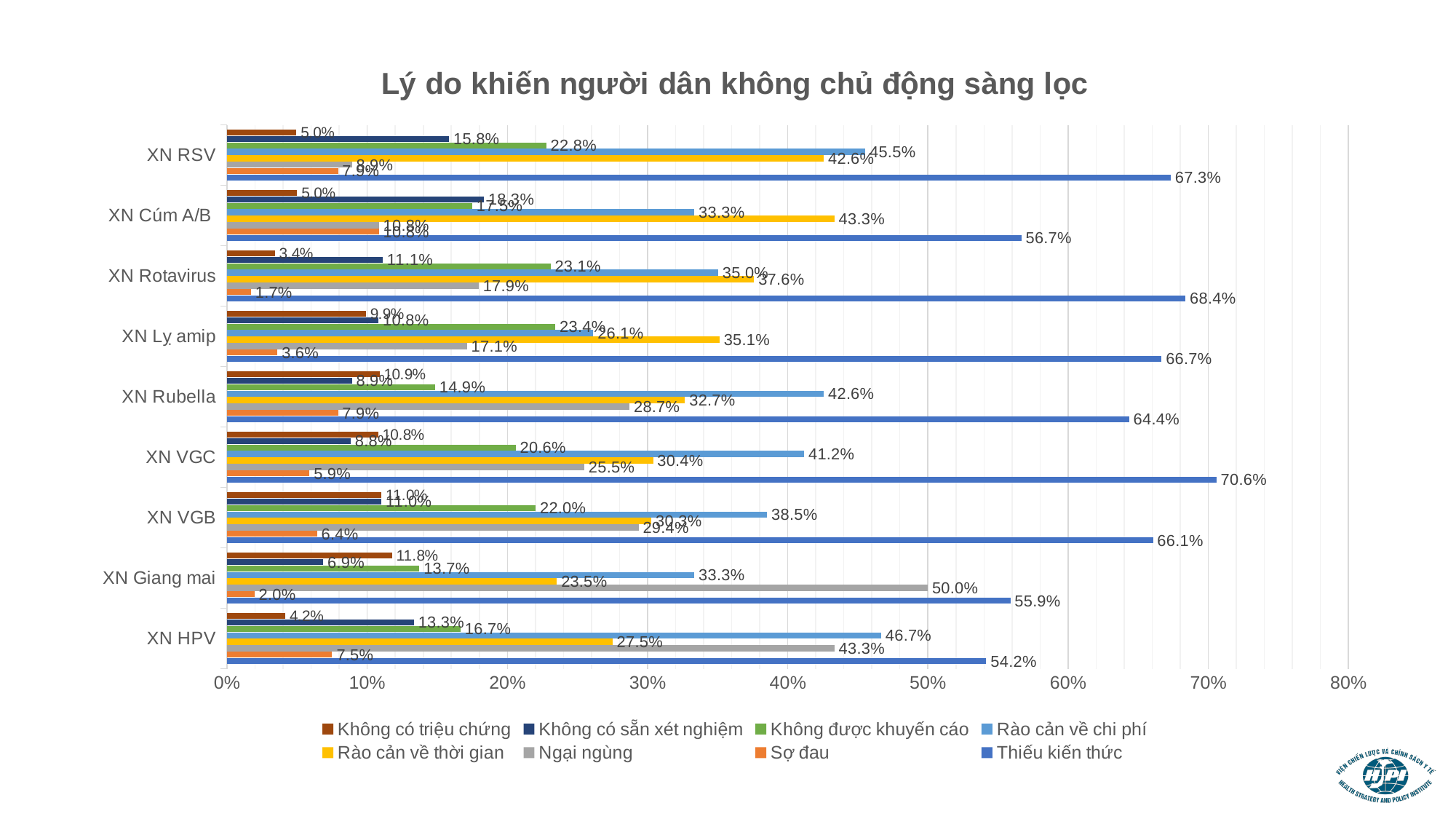
What is the title of the chart? Lý do khiến người dân không chủ động sàng lọc What is the value of 'Sợ đau' for XN Rotavirus? 1.7% Which test category has the highest value for 'Thiếu kiến thức'? XN VGC Is the 'Thiếu kiến thức' value for XN Rotavirus greater or less than 60%? greater Which test category has the lowest value for 'Thiếu kiến thức'? XN HPV Which has the larger 'Rào cản về chi phí' value, XN Rubella or XN Lỵ amip? XN Rubella How many test categories (XN) are listed on the vertical axis? 9 What is the difference between the 'Thiếu kiến thức' values for XN RSV and XN HPV? 13.1 percentage points What is the value of 'Thiếu kiến thức' for XN VGC? 70.6% What is the value of 'Ngại ngùng' for XN Giang mai? 50.0% What kind of chart is shown on the slide? Bar chart How many series does the legend list? 8